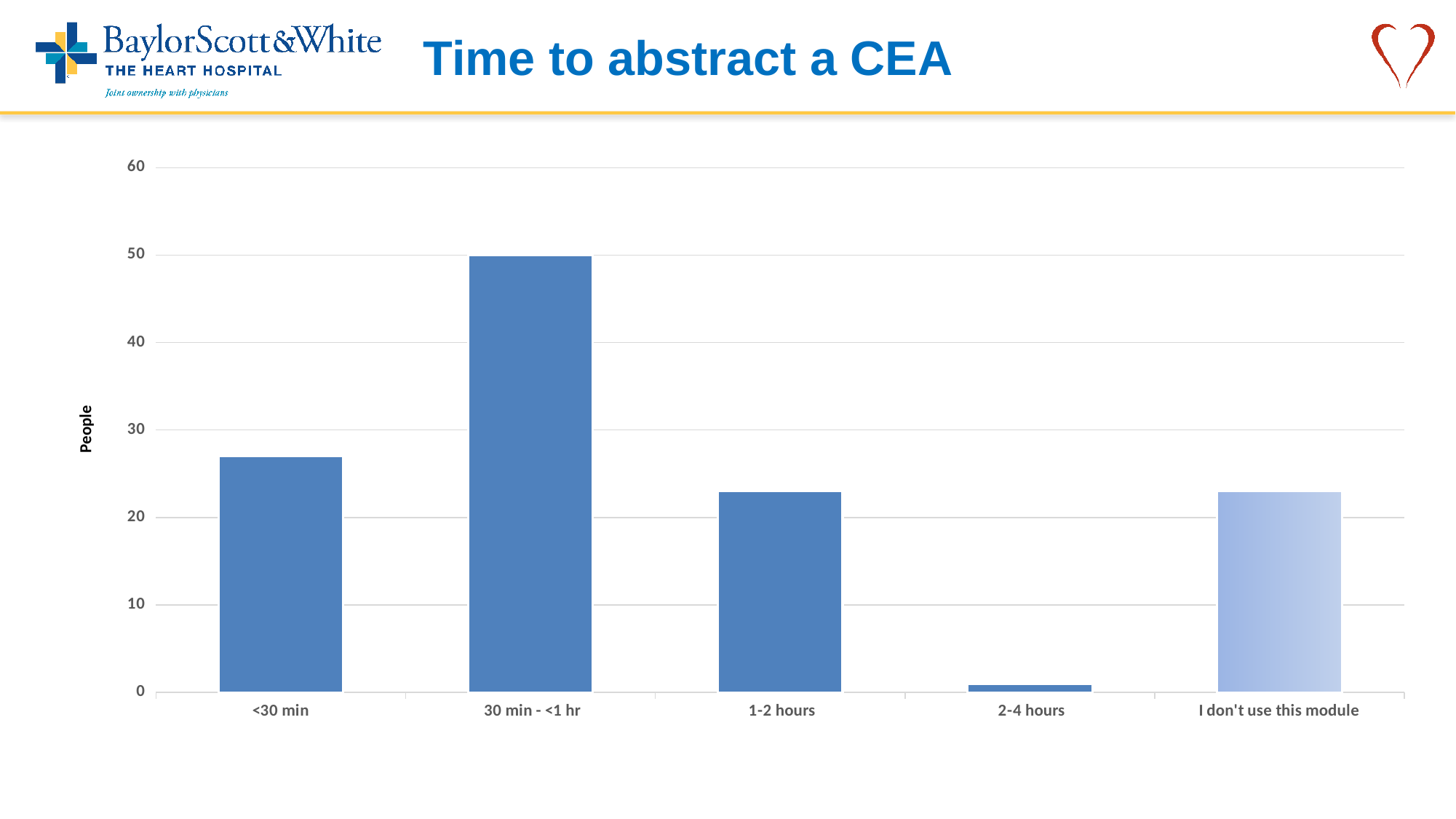
Is the value for <30 min greater or less than 30? less Which category has the lowest number of people? 2-4 hours Is the value for 2-4 hours greater or less than 10? less Is the value for 30 min - <1 hr greater or less than 40? greater How many categories are shown on the x axis of the chart? 5 What is the label on the y axis of the chart? People Which category has the highest number of people? 30 min - <1 hr Which has more people, <30 min or 1-2 hours? <30 min What kind of chart is shown on the slide? bar chart What is the title of the slide containing the chart? Time to abstract a CEA